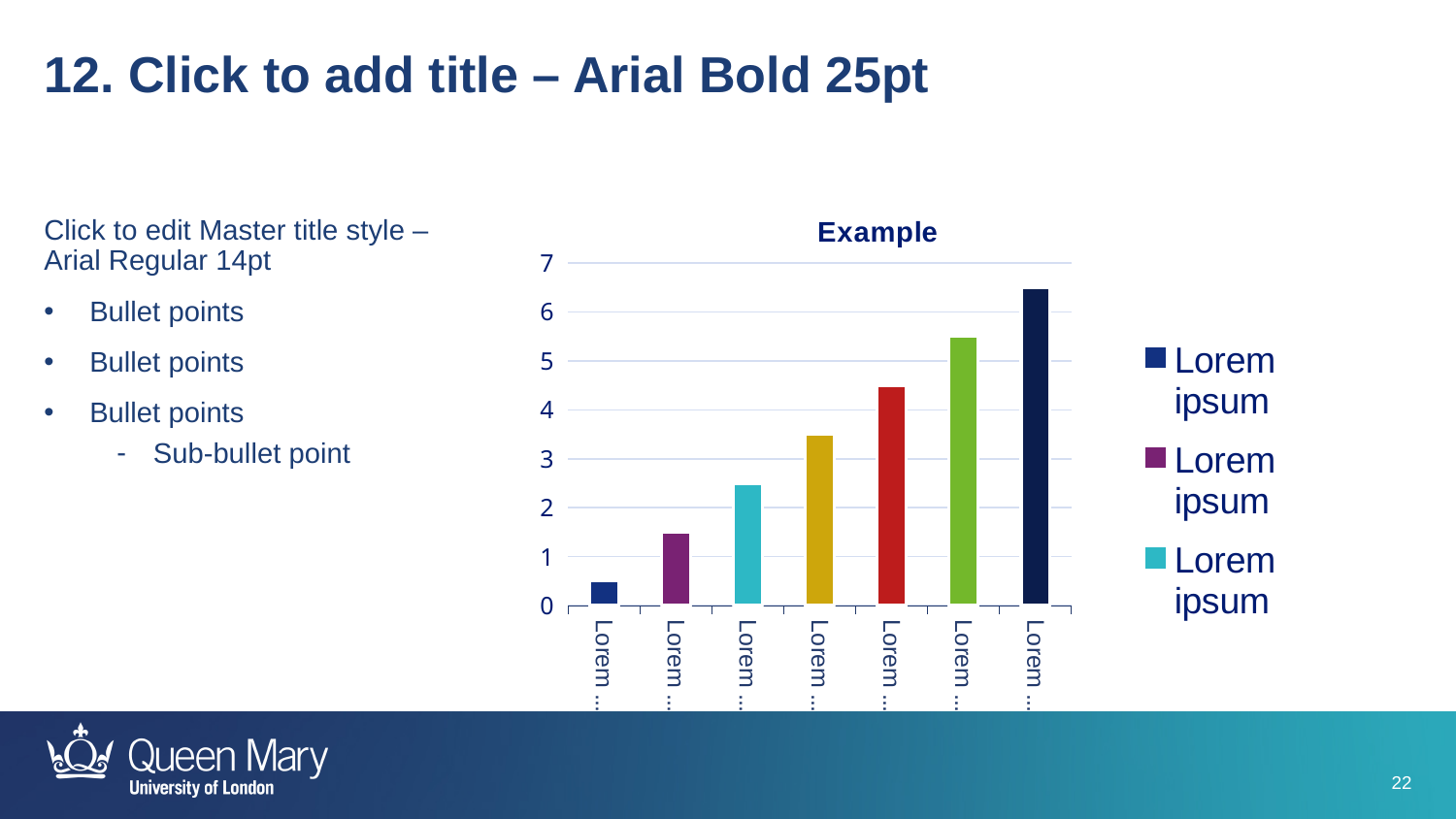
How many bars does the chart show? 7 What is the highest value shown on the chart's vertical axis? 7 Is the value of the first (leftmost) bar greater or less than 1? less Which is larger, the value of the second bar or the value of the fifth bar? the fifth bar How many entries does the chart's legend list? 3 What is the title of the chart on the slide? Example Which bar is the shortest in the chart? the first (leftmost) bar Which bar is the tallest in the chart? the seventh (rightmost) bar Is the value of the fourth bar greater or less than 3? greater Do the bar values rise or fall from left to right along the x axis? rise What kind of chart is shown on the slide? bar chart Is the value of the last (rightmost) bar greater or less than 6? greater